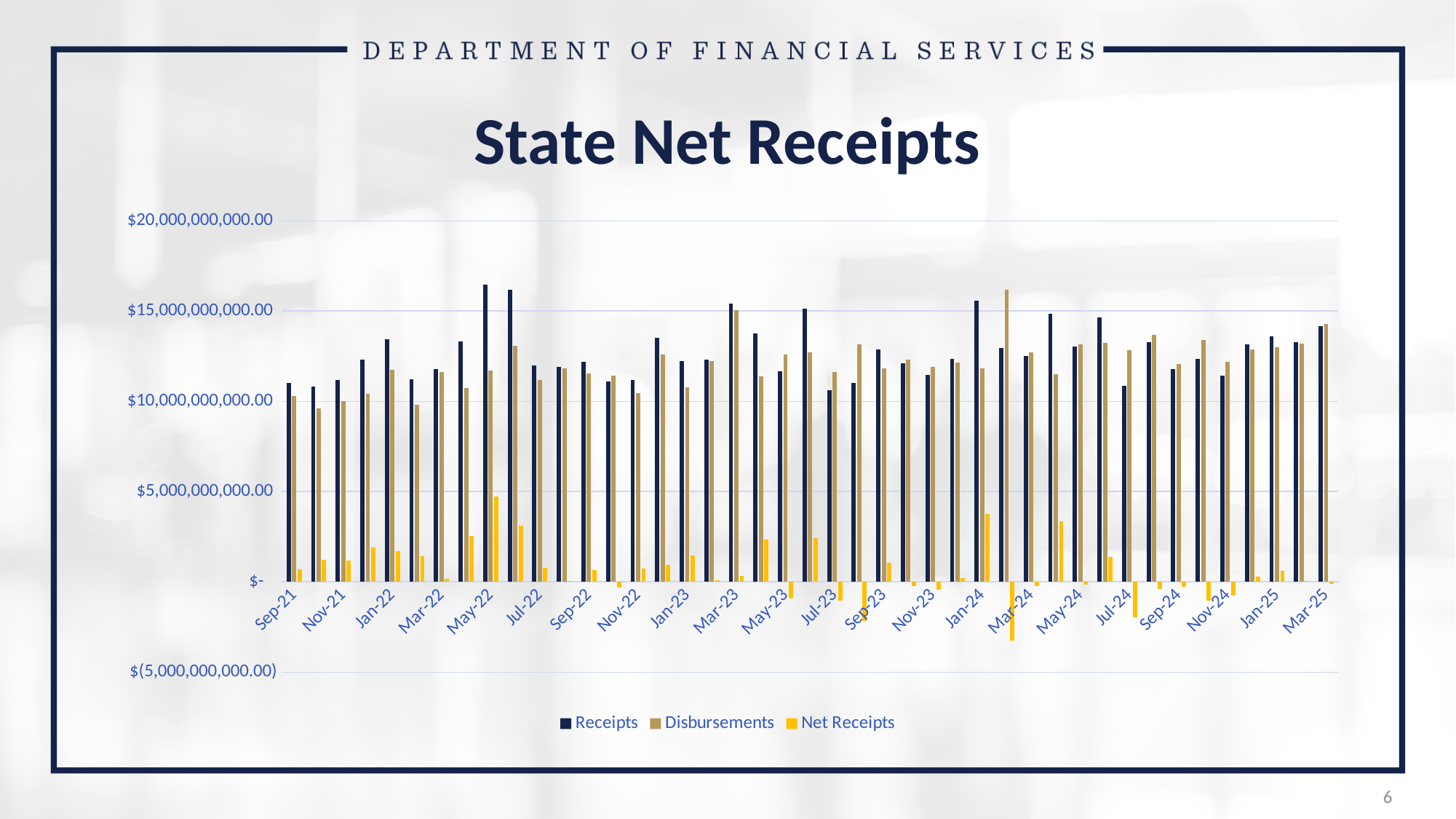
In which labelled month is the Net Receipts value lowest? Jul-24 Is the Disbursements value for Jan-22 greater or less than $10,000,000,000.00? greater In which labelled month is the Disbursements value highest? Mar-23 What kind of chart is shown on the slide? Bar chart Is the Receipts value for Mar-25 greater or less than $15,000,000,000.00? less Which series is shown in yellow in the legend? Net Receipts What is the title of the chart? State Net Receipts How many month labels are shown on the x axis? 22 How many series does the legend list? 3 Is the Receipts value for May-22 greater or less than $15,000,000,000.00? greater In which labelled month is the Net Receipts value highest? May-22